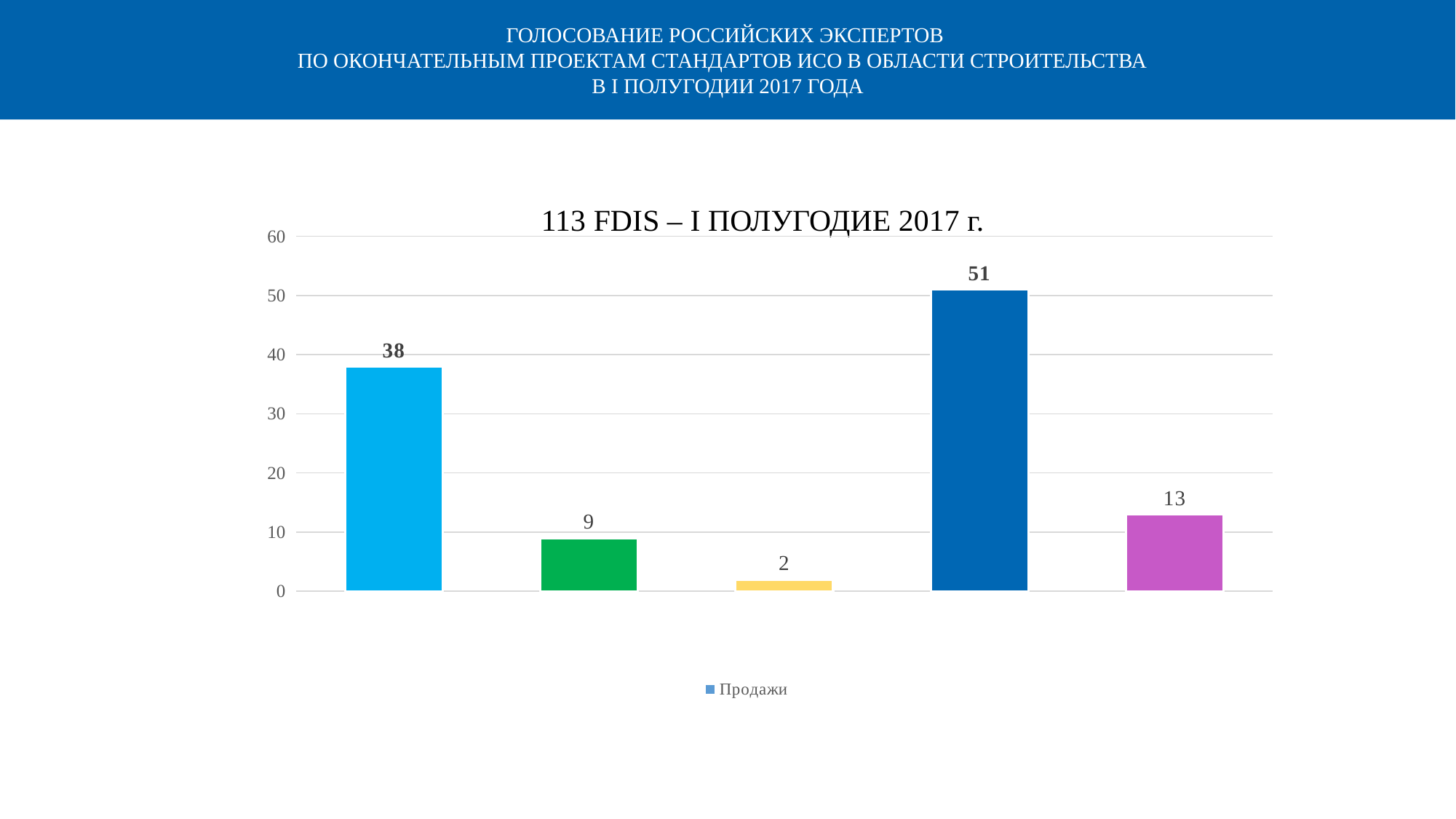
What is the value shown on the yellow bar? 2 Which is larger, the value of the purple bar or the value of the green bar? The purple bar (13) What is the difference between the dark blue bar (51) and the light blue bar (38)? 13 What is the value shown on the dark blue bar? 51 What is the value shown on the rightmost (purple) bar? 13 What is the value shown on the first (leftmost, light blue) bar? 38 How many bars are plotted in the chart? 5 Which bar has the lowest value? The yellow bar (2) What type of chart is shown on the slide? Bar chart What is the value shown on the green bar? 9 Which bar has the highest value? The dark blue bar (51) What is the title of the chart? 113 FDIS – I ПОЛУГОДИЕ 2017 г.